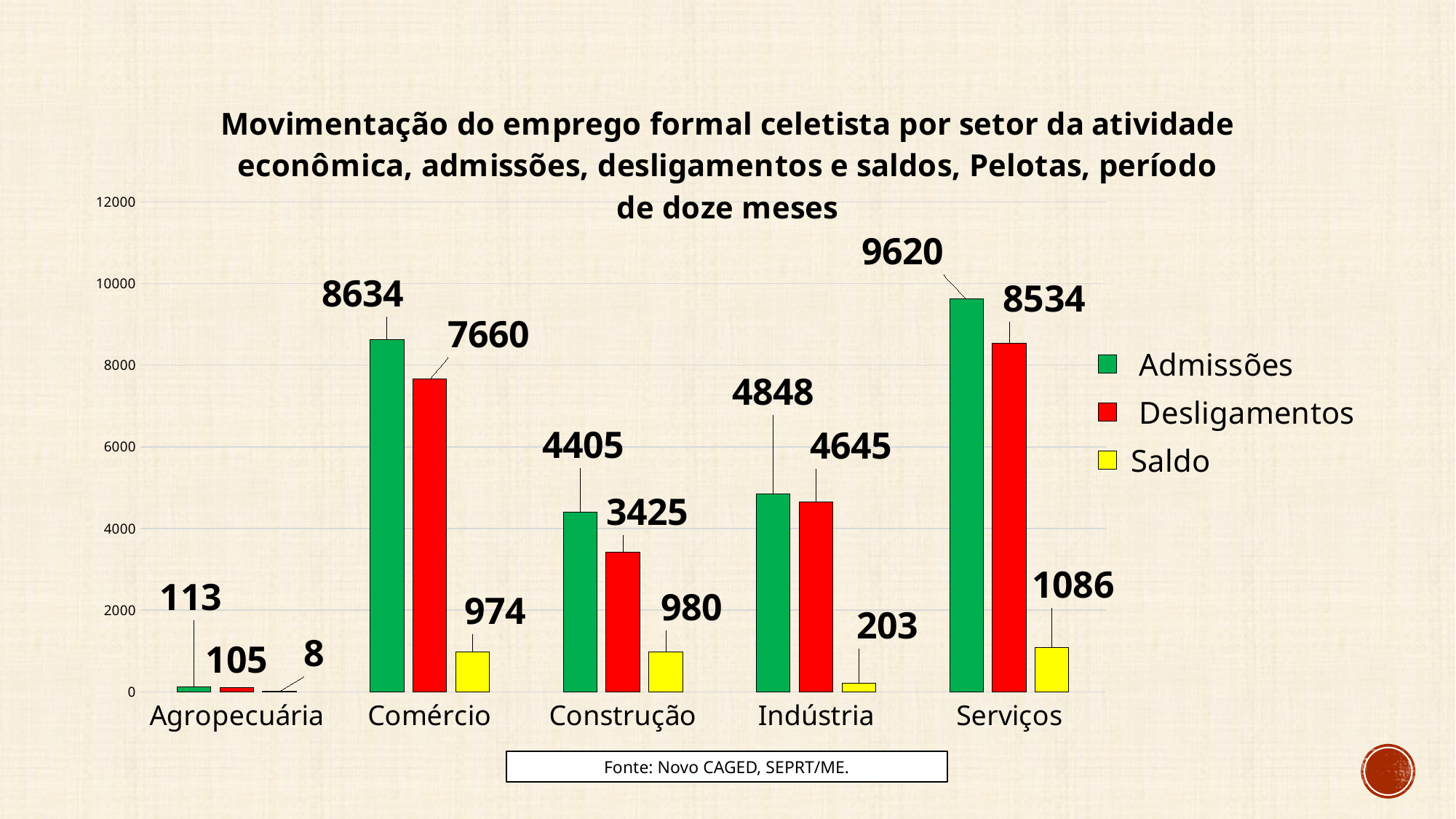
Which is larger for Indústria, Admissões or Desligamentos? Admissões What colour represents the Saldo series? yellow What kind of chart is shown on the slide? bar chart How many sectors are shown on the x axis? 5 Which sector has the highest Admissões value? Serviços Which sector has the lowest Saldo value? Agropecuária What is the Saldo value for Indústria? 203 How many series does the legend list? 3 What is the value of Admissões for Serviços? 9620 Is the Desligamentos value for Serviços greater or less than 8000? greater What is the value of Desligamentos for Comércio? 7660 What is the difference between Admissões and Desligamentos for Construção? 980